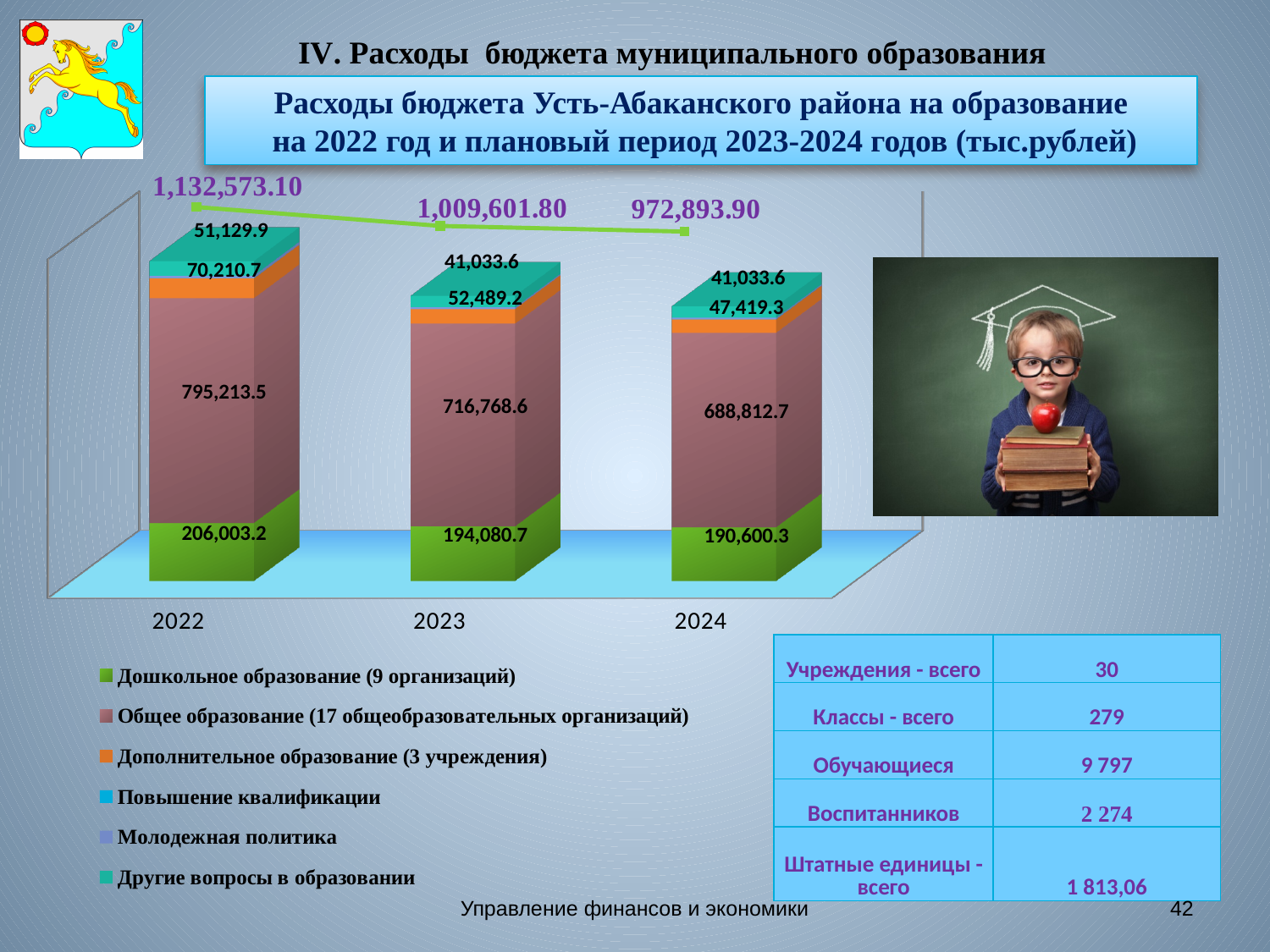
Which year has the highest value for Общее образование? 2022 Do the total expenditure values rise or fall from 2022 to 2024? Fall What is the total education expenditure shown for 2022? 1,132,573.10 How many series does the chart legend list? 6 What is the value for Общее образование in 2023? 716,768.6 What is the value for Дошкольное образование in 2022? 206,003.2 How many years (categories) are shown on the x axis of the chart? 3 What is the value for Дополнительное образование in 2024? 47,419.3 What is the difference between the Общее образование values for 2022 and 2023? 78,444.9 Which year has the lowest value for Дошкольное образование? 2024 What is the total education expenditure shown for 2024? 972,893.90 What kind of chart is shown on the slide? Stacked bar chart with a line